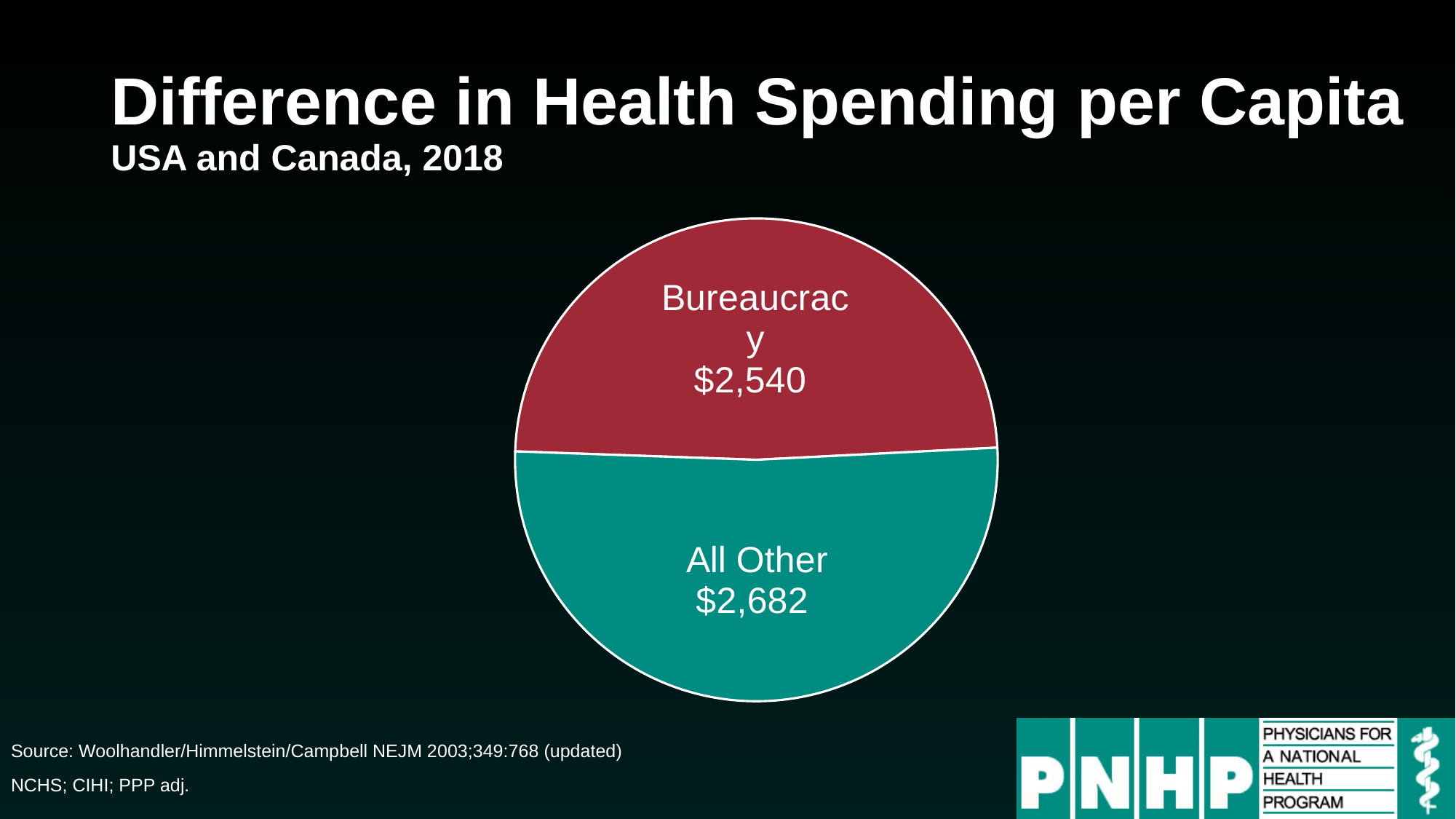
How many slices does the pie chart have? 2 What is the value of the All Other slice in the pie chart? $2,682 Which slice of the pie chart has the smaller value? Bureaucracy What is the total of the two slices in the pie chart? $5,222 What kind of chart is shown on the slide? pie chart Which slice of the pie chart has the larger value? All Other What colour is the All Other slice of the pie chart? teal What is the title of the chart on the slide? Difference in Health Spending per Capita Is the value for Bureaucracy larger or smaller than the value for All Other? smaller What is the value of the Bureaucracy slice in the pie chart? $2,540 What is the difference between the All Other value and the Bureaucracy value? $142 What share of the pie does the Bureaucracy slice represent, to one decimal place? 48.6%